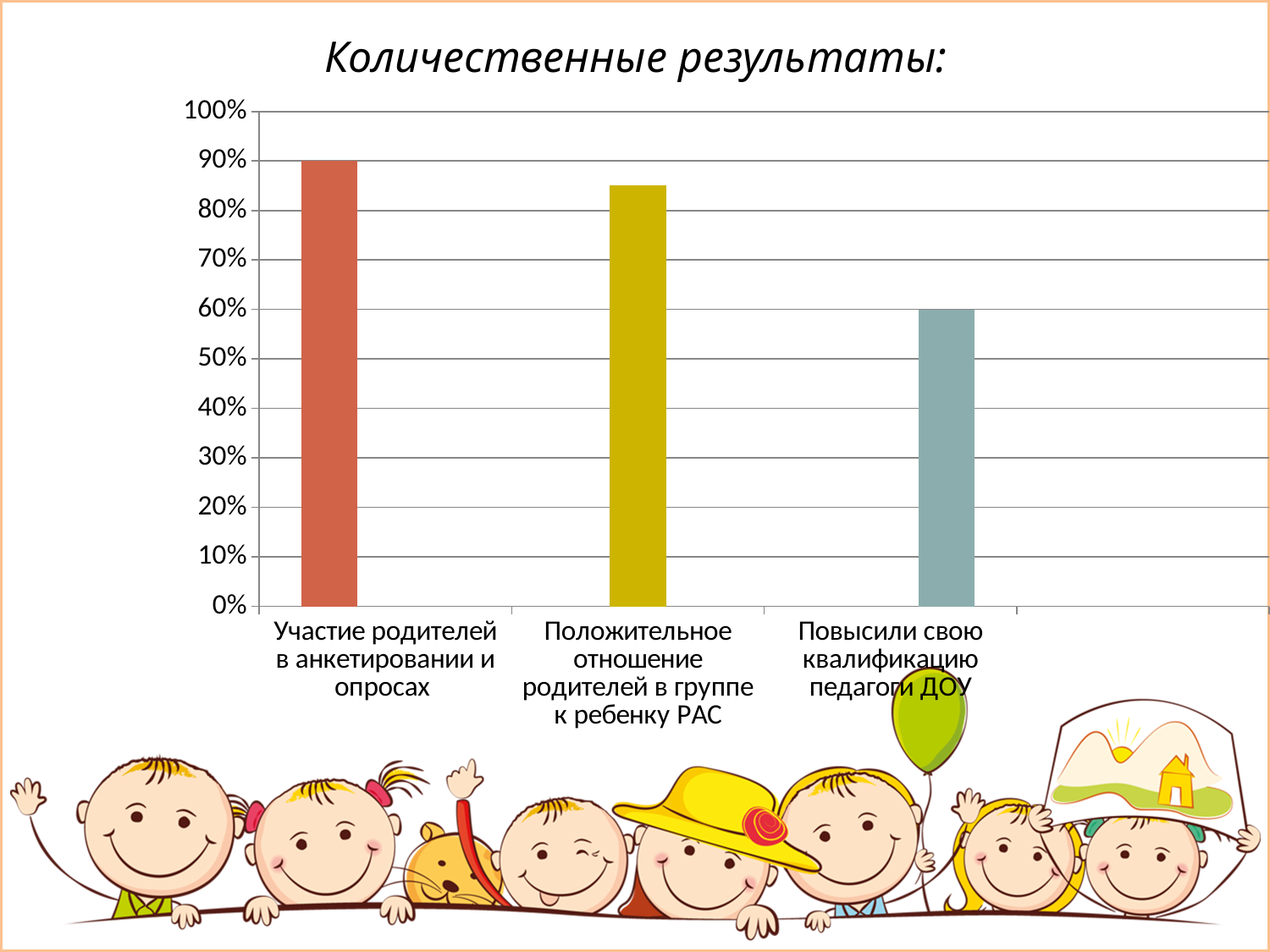
What kind of chart is shown on the slide? Bar chart What is the title of the chart? Количественные результаты: What is the difference between the values for "Участие родителей в анкетировании и опросах" and "Повысили свою квалификацию педагоги ДОУ"? 30% Which category has the highest value? Участие родителей в анкетировании и опросах How many categories are shown in the chart? 3 What is the value for "Участие родителей в анкетировании и опросах"? 90% Is the value for "Положительное отношение родителей в группе к ребенку РАС" greater or less than 80%? greater Do the values rise or fall from left to right across the categories? Fall Which is larger: the value for "Положительное отношение родителей в группе к ребенку РАС" or the value for "Повысили свою квалификацию педагоги ДОУ"? Положительное отношение родителей в группе к ребенку РАС What is the value for "Повысили свою квалификацию педагоги ДОУ"? 60% Which category has the lowest value? Повысили свою квалификацию педагоги ДОУ Is the value for "Положительное отношение родителей в группе к ребенку РАС" greater or less than 90%? less